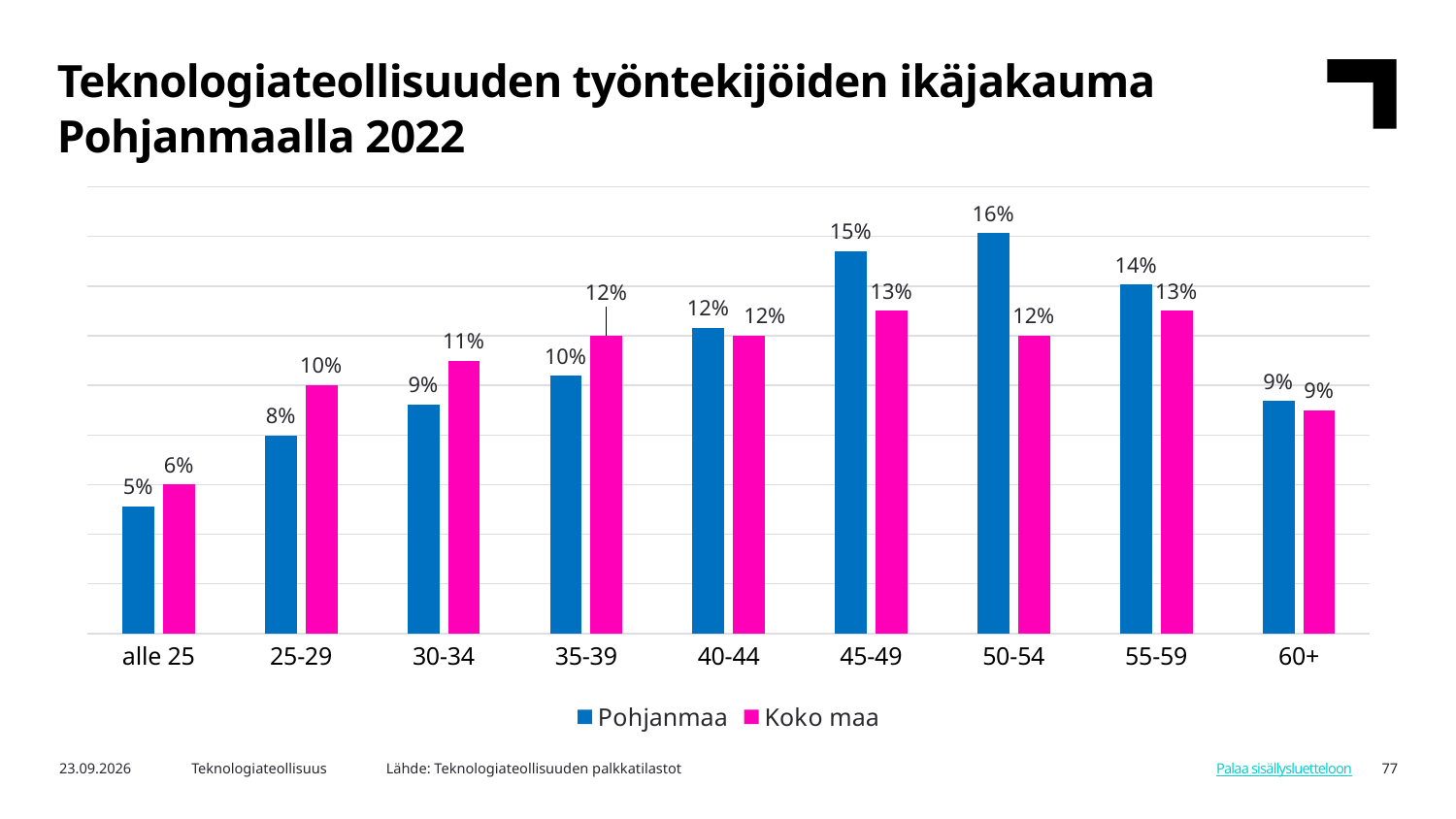
How many age groups are shown on the x axis? 9 What is the value for Koko maa in the 25-29 age group? 10% Which age group has the lowest value for Koko maa? alle 25 What is the value for Pohjanmaa in the 50-54 age group? 16% Which age group has the highest value for Pohjanmaa? 50-54 How many series does the legend list? 2 What is the difference between Pohjanmaa and Koko maa in the 50-54 age group? 4 percentage points What kind of chart is shown on the slide? Bar chart In the 45-49 age group, which series has the larger value, Pohjanmaa or Koko maa? Pohjanmaa What is the value for Pohjanmaa in the alle 25 age group? 5% In the 30-34 age group, which series has the larger value, Pohjanmaa or Koko maa? Koko maa Which series is shown in pink? Koko maa